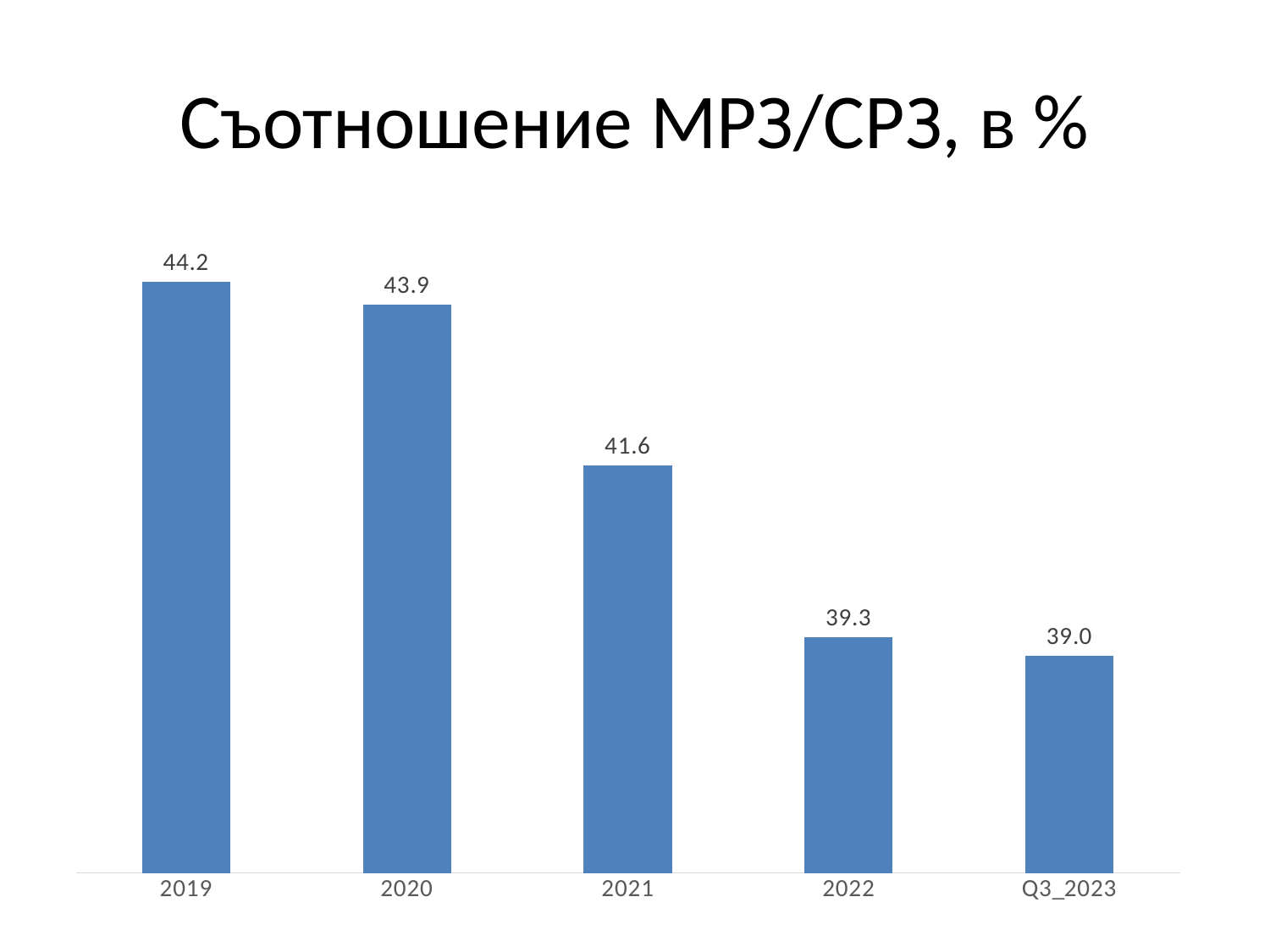
What is the difference between the values for 2019 and 2022? 4.9 What is the value for 2021? 41.6 What is the value for Q3_2023? 39.0 Which category has the highest value? 2019 How many categories are shown on the x axis? 5 Which category has the lowest value? Q3_2023 What is the difference between the values for 2020 and 2021? 2.3 Do the values rise or fall from 2019 to Q3_2023? fall Which is larger, the value for 2021 or the value for 2022? 2021 What is the title of the chart? Съотношение МРЗ/СРЗ, в % What is the value for 2019? 44.2 What kind of chart is this? bar chart